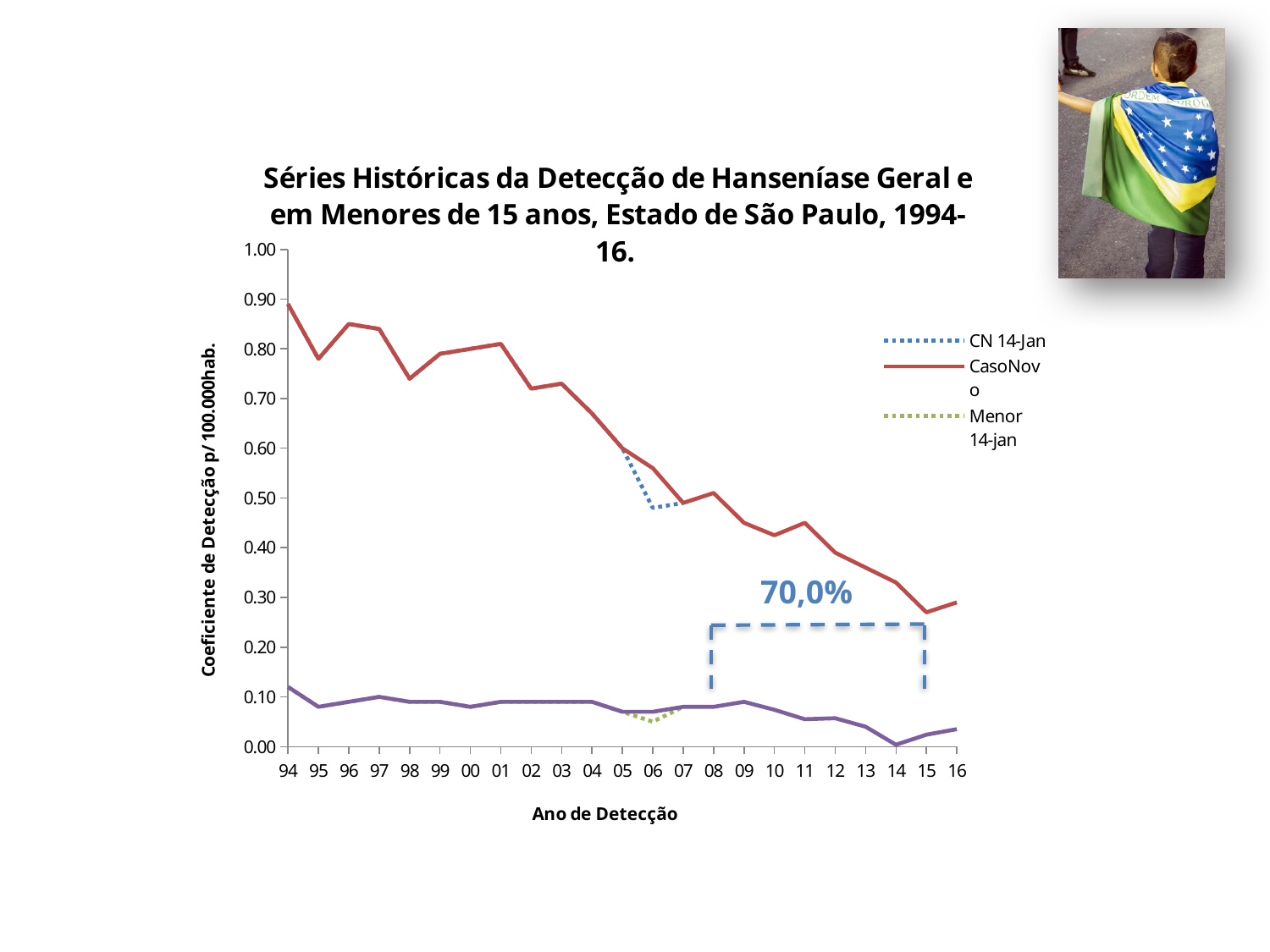
Is the CasoNovo value for 05 greater or less than 0.50? greater How many series does the legend list? 3 Does the CasoNovo series generally rise or fall from 94 to 16? fall How many years are shown along the x axis? 23 Is the CasoNovo value for 16 greater or less than 0.40? less What kind of chart is shown on the slide? line chart In which year is the CasoNovo series highest? 94 Is the CasoNovo value for 94 greater or less than 0.80? greater Which is larger for the CasoNovo series, the value for 01 or the value for 02? 01 What percentage is written in the annotation above the bracket spanning 08 to 15? 70,0% Which is larger for the CasoNovo series, the value for 94 or the value for 98? 94 What is the label of the y axis? Coeficiente de Detecção p/ 100.000hab.